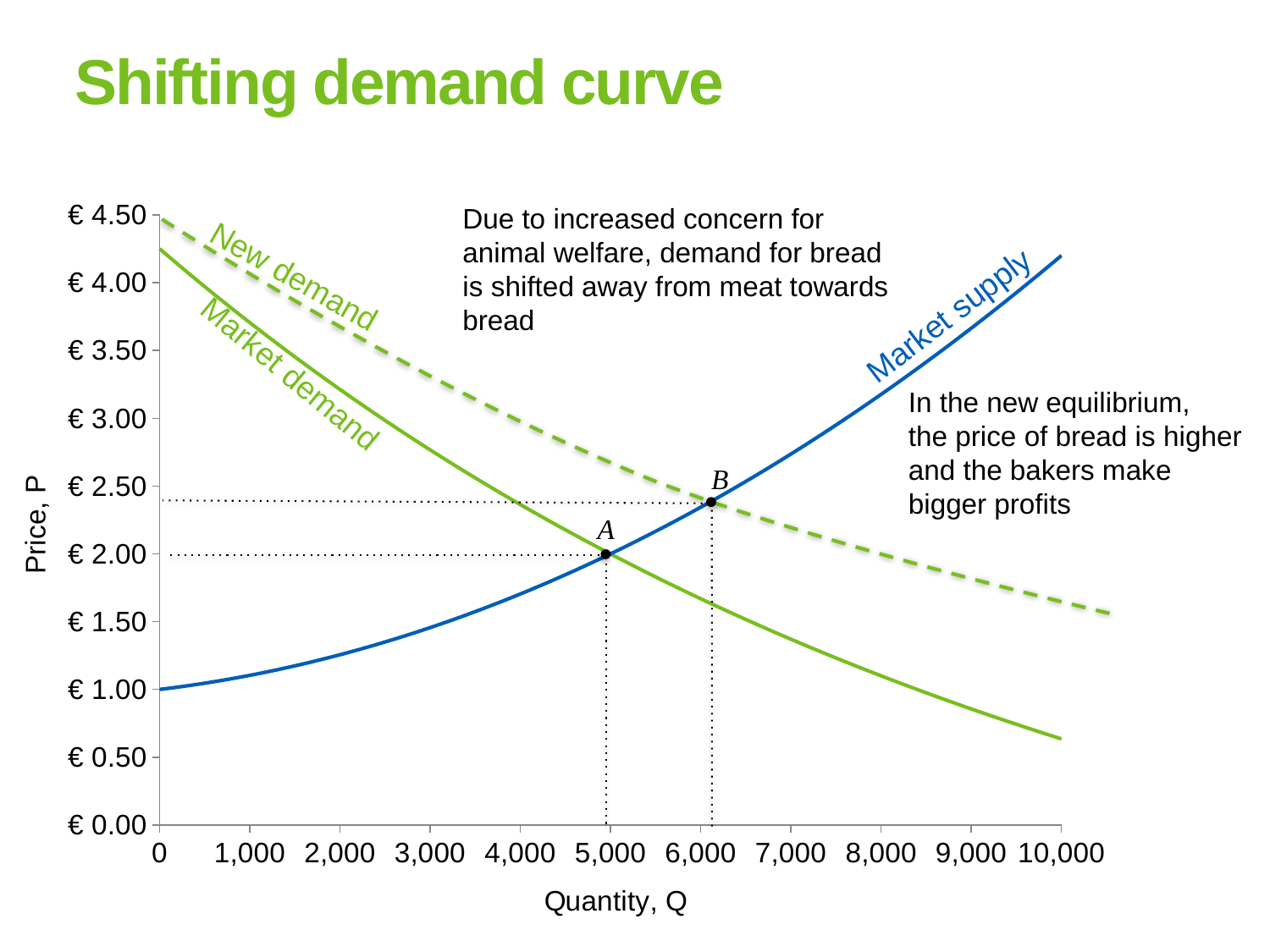
How many curves are plotted on the chart? 3 Which equilibrium point has the higher price, A or B? B Does the Market supply curve rise or fall as quantity increases? rises What kind of chart is shown on the slide? line chart What is the price on the Market supply curve at a quantity of 0? € 1.00 Which curve is drawn as a dashed line? New demand Does the Market demand curve rise or fall as quantity increases? falls Is the quantity at point B greater or less than 6,000? greater What is the price at equilibrium point A? € 2.00 Is the price at point B greater or less than € 2.00? greater Is the quantity at point A greater or less than 6,000? less